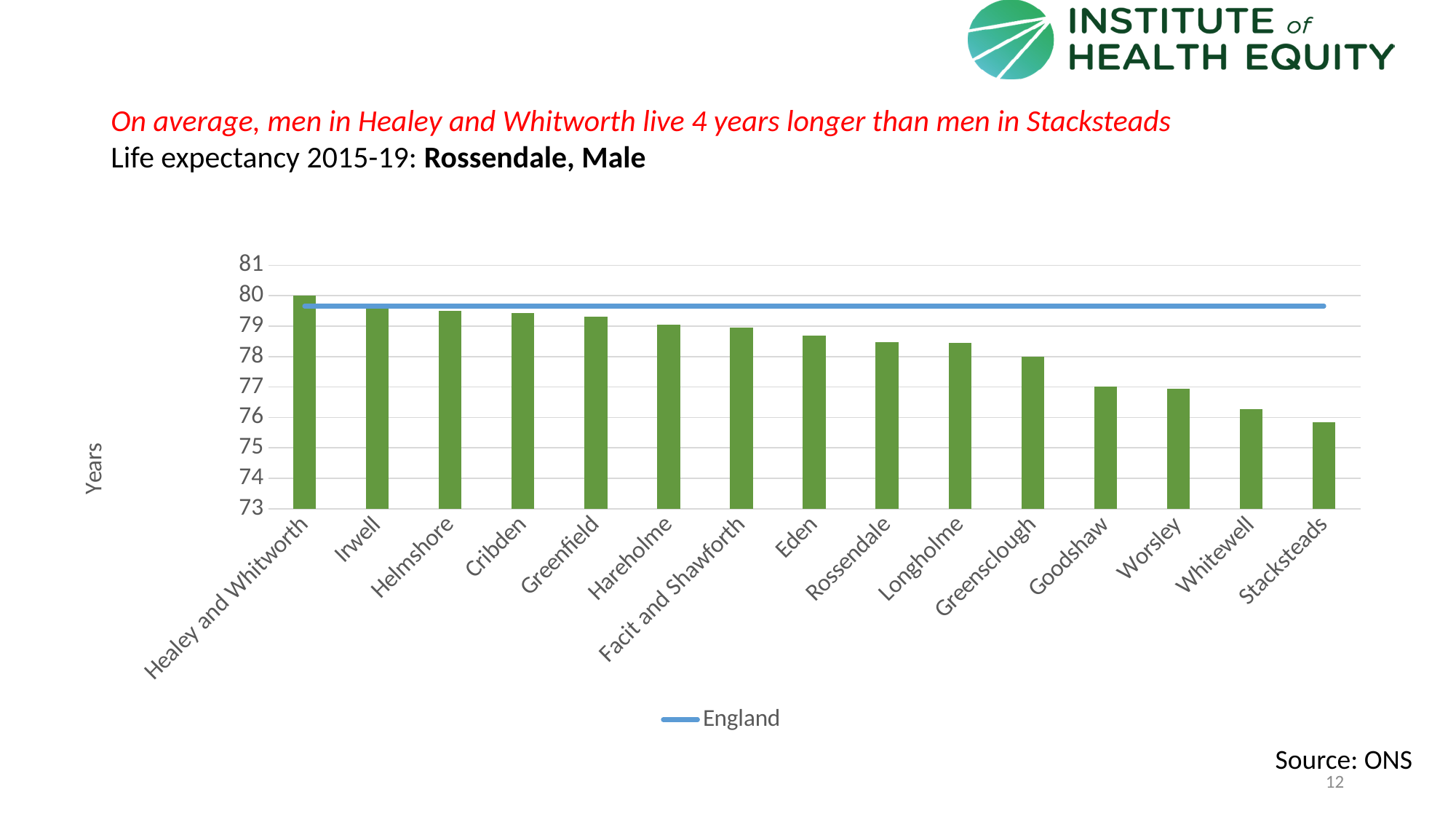
What kind of chart is shown on the slide? bar chart Do the bar values rise or fall from left to right along the x axis? fall Which ward has the highest male life expectancy? Healey and Whitworth Which is larger, the value for Goodshaw or the value for Cribden? Cribden Which ward has the lowest male life expectancy? Stacksteads How many series does the legend list? 1 Is the value for Stacksteads greater or less than 76? less What is the label on the y axis? Years How many wards (categories) are plotted on the x axis? 15 Which is larger, the value for Irwell or the value for Stacksteads? Irwell